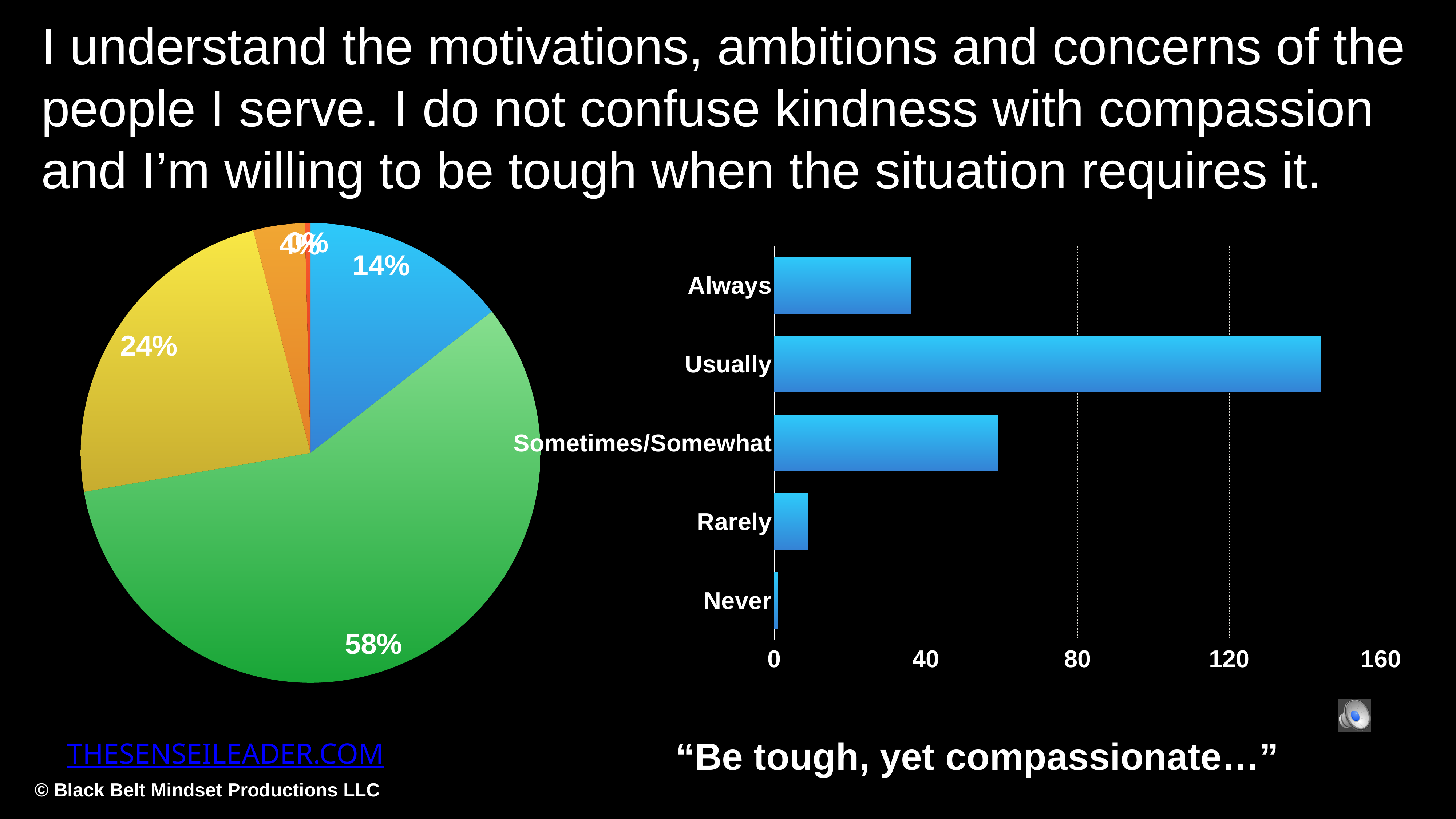
In the bar chart on the right, is the value for Sometimes/Somewhat greater or less than 80? less In the pie chart on the left, what percentage is shown on the yellow slice? 24% In the bar chart on the right, is the value for Usually greater or less than 120? greater In the bar chart on the right, which category has the longest bar? Usually In the bar chart on the right, how many categories are shown? 5 In the bar chart on the right, which is larger, the value for Always or the value for Sometimes/Somewhat? Sometimes/Somewhat In the bar chart on the right, which category has the shortest bar? Never In the bar chart on the right, is the value for Rarely greater or less than 40? less What kind of chart is on the right side of the slide? bar chart In the pie chart on the left, what percentage is shown on the green slice? 58% In the pie chart on the left, what percentage is shown on the blue slice? 14% What kind of chart is on the left side of the slide? pie chart